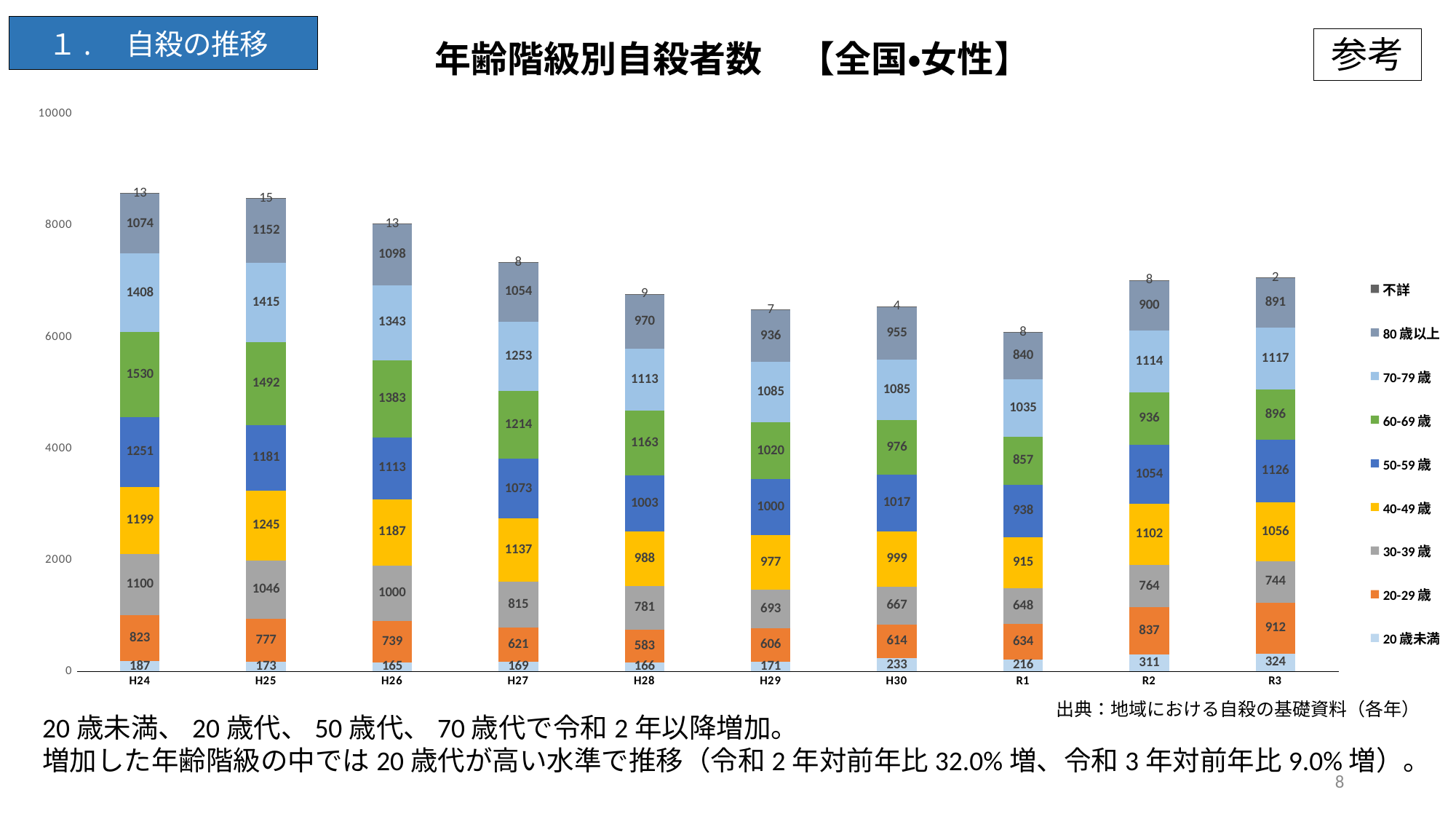
How many years (categories) are shown on the x axis? 10 In which year is the value for 20歳未満 the highest? R3 Is the total of the stacked bar for H28 greater or less than 6000? greater In which year is the value for 20-29歳 the lowest? H28 What is the value for 60-69歳 in H24? 1530 What is the total of the stacked bar for H24? 8585 Which is larger, the 50-59歳 value in R3 or in R2? R3 What is the value for 不詳 in R3? 2 What type of chart is shown on the slide? Stacked bar chart What is the difference between the 20-29歳 values in R2 and R1? 203 How many series does the legend list? 9 What is the value for 20-29歳 in R2? 837